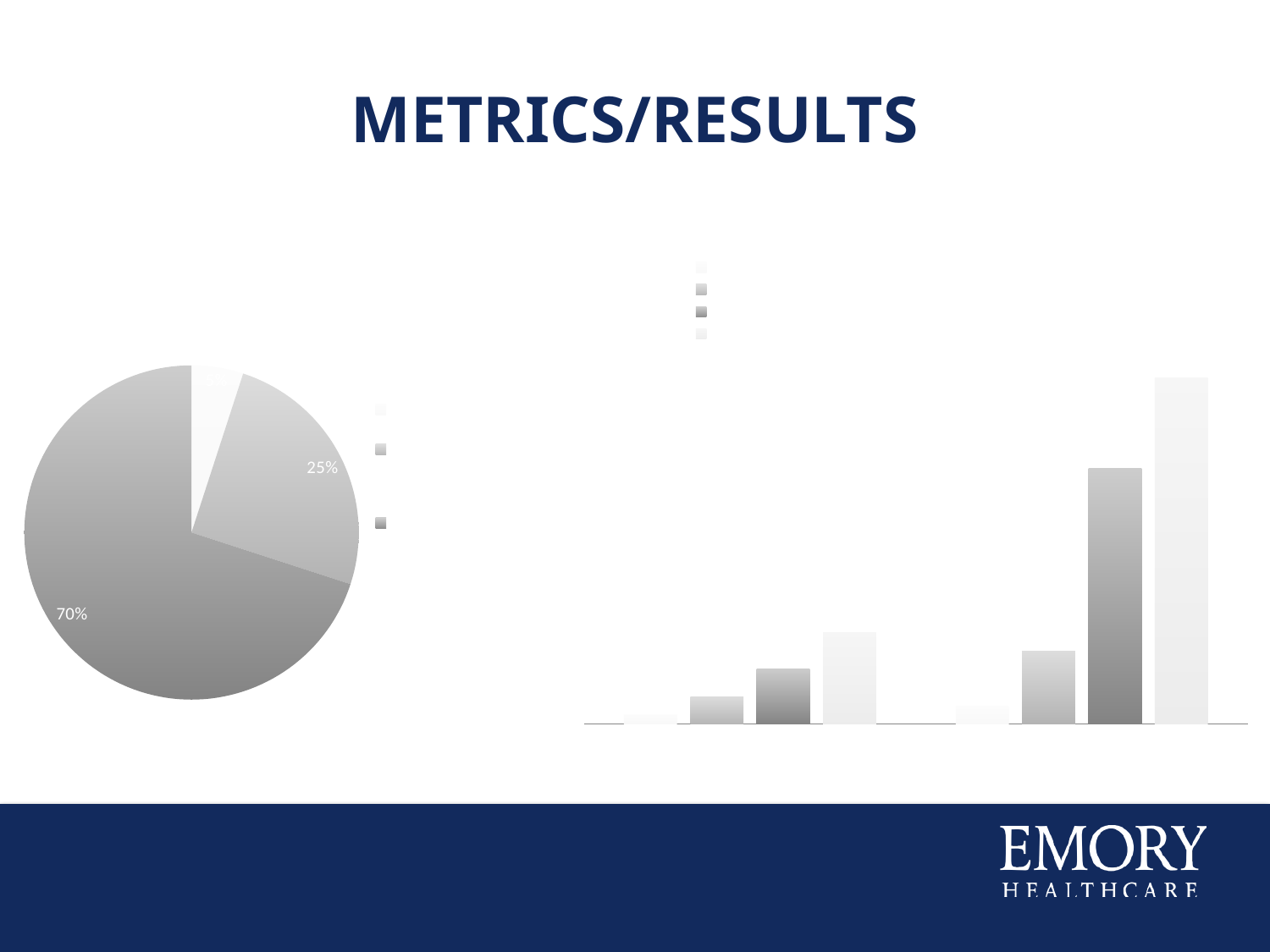
In the bar chart on the right, how many bars are plotted? 8 In the bar chart on the right, do the bars within each group of four rise or fall from left to right? Rise In the pie chart on the left, which is larger: the slice labelled 70% or the slice labelled 25%? The 70% slice In the pie chart on the left, what is the difference in percentage points between the 70% slice and the 25% slice? 45 percentage points In the bar chart on the right, how many entries does the legend list? 4 In the pie chart on the left, how many slices are there? 3 What kind of chart is on the right side of the slide? Bar chart In the pie chart on the left, what value is printed on the second-largest slice? 25% In the pie chart on the left, what is the value shown on the largest slice? 70% What kind of chart is on the left side of the slide? Pie chart In the pie chart on the left, how many entries does the legend list? 3 In the bar chart on the right, which bar is the tallest? The rightmost bar